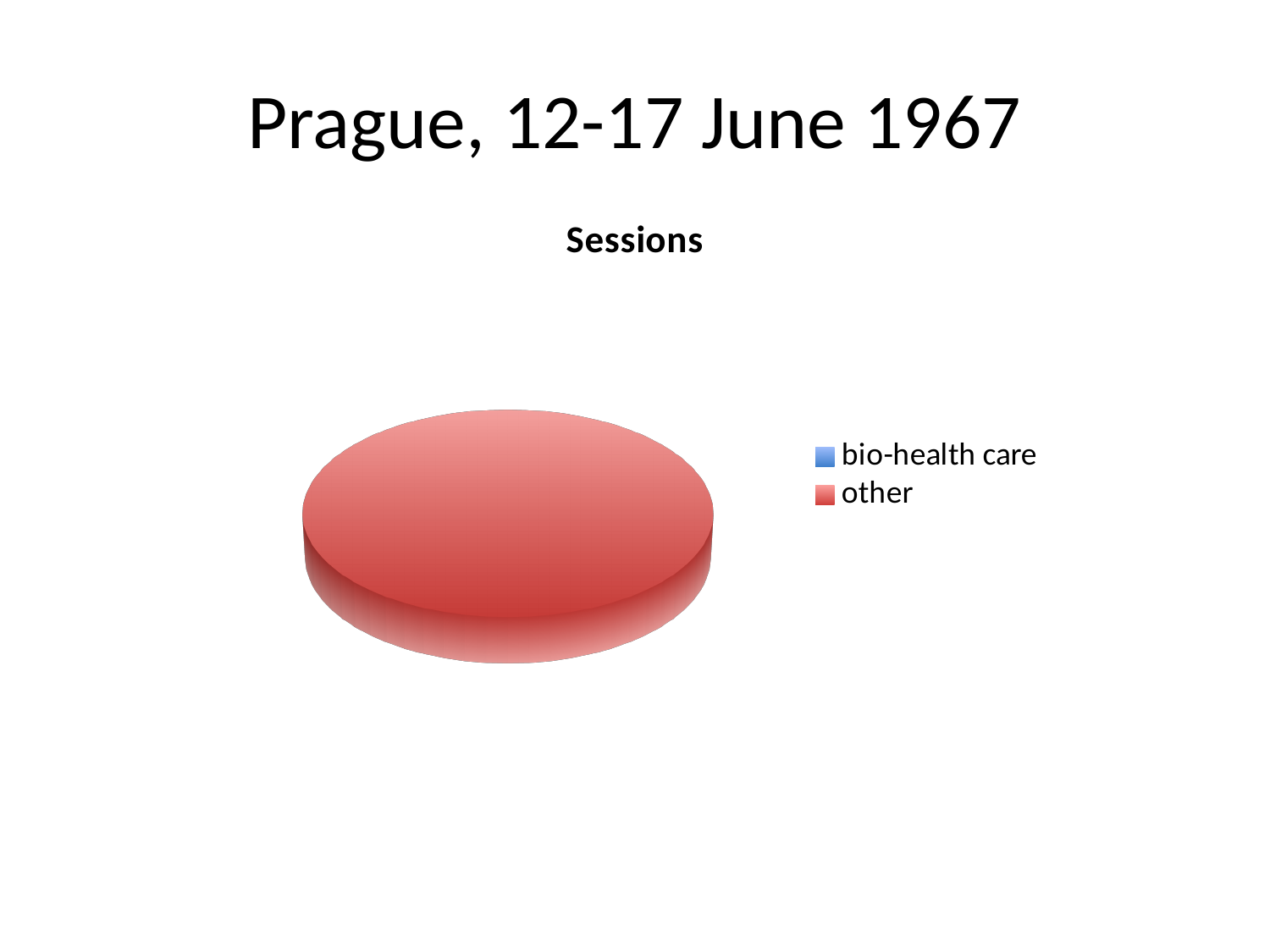
Is the 'bio-health care' slice visible in the pie? No How many categories does the legend of the chart list? 2 What is the title of the chart? Sessions Which category takes up the largest share of the pie? other What kind of chart is shown on the slide? pie chart Which category takes up the smallest share of the pie? bio-health care What colour represents the 'other' category in the chart? red Which category has the larger share of the pie, bio-health care or other? other